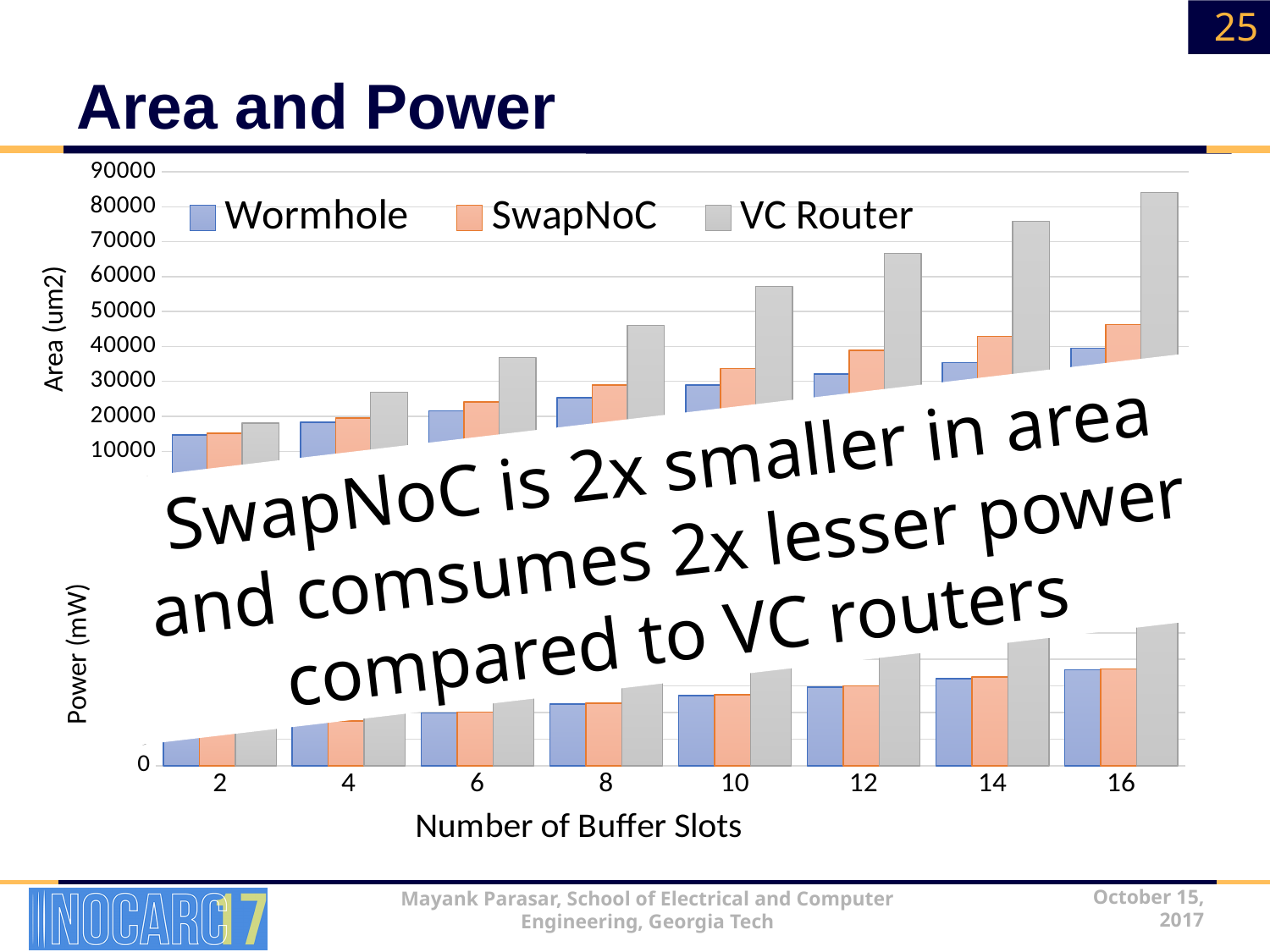
What is the x-axis title shared by the charts? Number of Buffer Slots In the top Area chart, which series has the tallest bar at 16 buffer slots? VC Router In the top Area chart, is the Wormhole value at 2 buffer slots greater or less than 10000? greater How many series does the legend list? 3 In the bottom Power chart, which series has the tallest bar at 16 buffer slots? VC Router What kind of chart is the top chart (Area)? bar chart How many buffer-slot categories are shown along the x axis? 8 In the top Area chart, which is larger at 8 buffer slots: SwapNoC or VC Router? VC Router In the top Area chart, is the SwapNoC value at 16 buffer slots greater or less than 40000? greater In the top Area chart, is the VC Router value at 10 buffer slots greater or less than 50000? greater In the top Area chart, do the VC Router values rise or fall as the number of buffer slots increases? rise